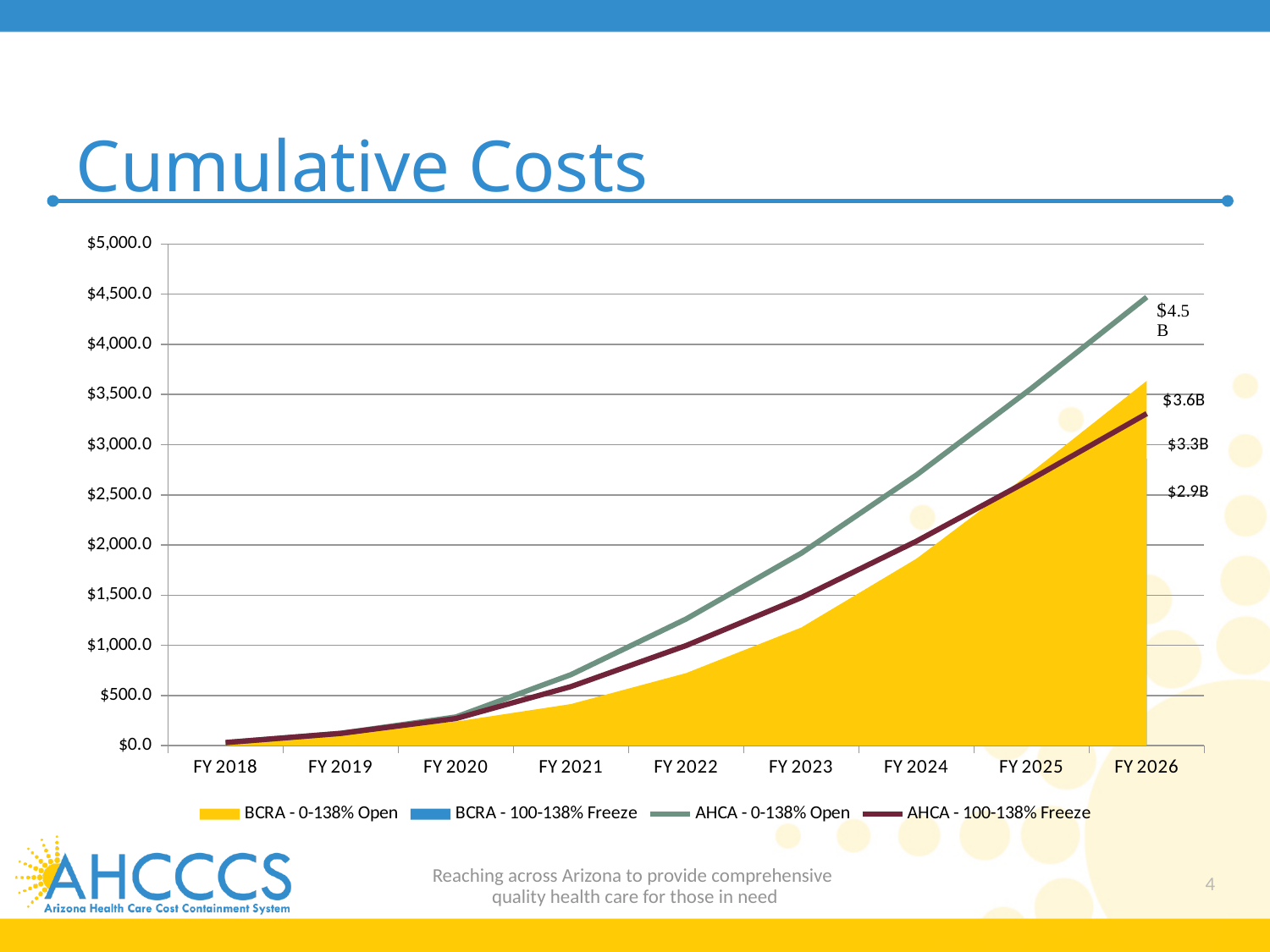
How many fiscal years are shown on the x axis? 9 What is the title of the chart? Cumulative Costs Which series has the highest cumulative cost at FY 2026? AHCA - 0-138% Open What is the difference between the FY 2026 values for AHCA - 0-138% Open and BCRA - 0-138% Open? $0.8B At FY 2022, which is larger: AHCA - 0-138% Open or AHCA - 100-138% Freeze? AHCA - 0-138% Open What is the labelled value for BCRA - 0-138% Open at FY 2026? $3.6B Do the cumulative costs rise or fall from FY 2018 to FY 2026? rise Is the value for BCRA - 0-138% Open at FY 2023 greater or less than $1,500.0? less What is the labelled value for AHCA - 100-138% Freeze at FY 2026? $3.3B Is the value for AHCA - 0-138% Open at FY 2023 greater or less than $1,500.0? greater What is the labelled value for AHCA - 0-138% Open at FY 2026? $4.5B How many series does the legend list? 4